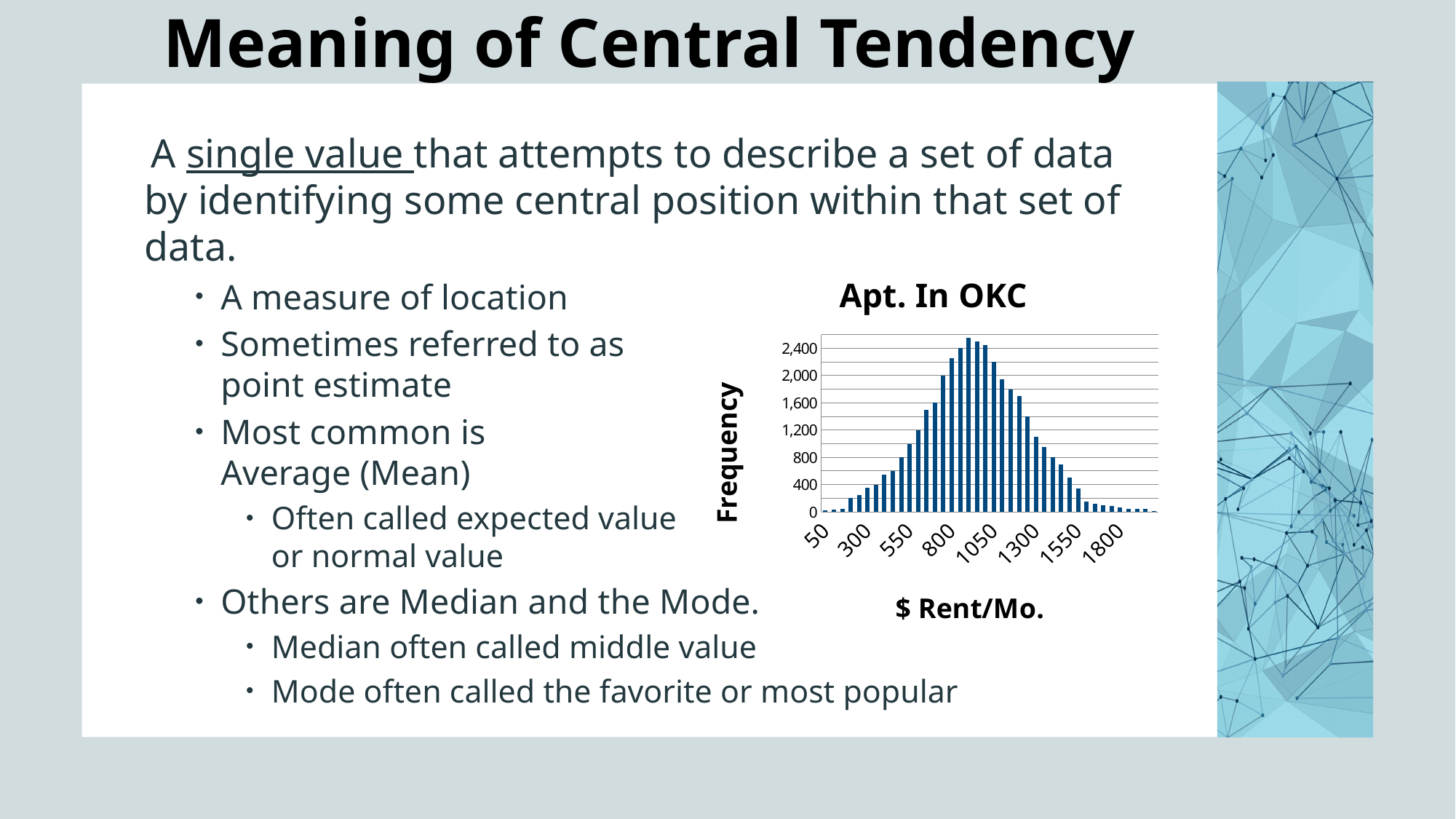
Is the frequency for a rent of 1800 greater or less than 400? less How many tick labels are shown on the horizontal axis of the chart? 8 Is the frequency for a rent of 1300 greater or less than 1,600? less Do the frequencies rise or fall as rent increases from 1050 to 1800? fall Which has the higher frequency, a rent of 800 or a rent of 1800? 800 Is the frequency for a rent of 1300 greater or less than 800? greater What kind of chart is shown under the title "Apt. In OKC"? bar chart Do the frequencies rise or fall as rent increases from 50 to 800? rise What is the label on the vertical axis of the chart? Frequency What is the title of the chart on the slide? Apt. In OKC